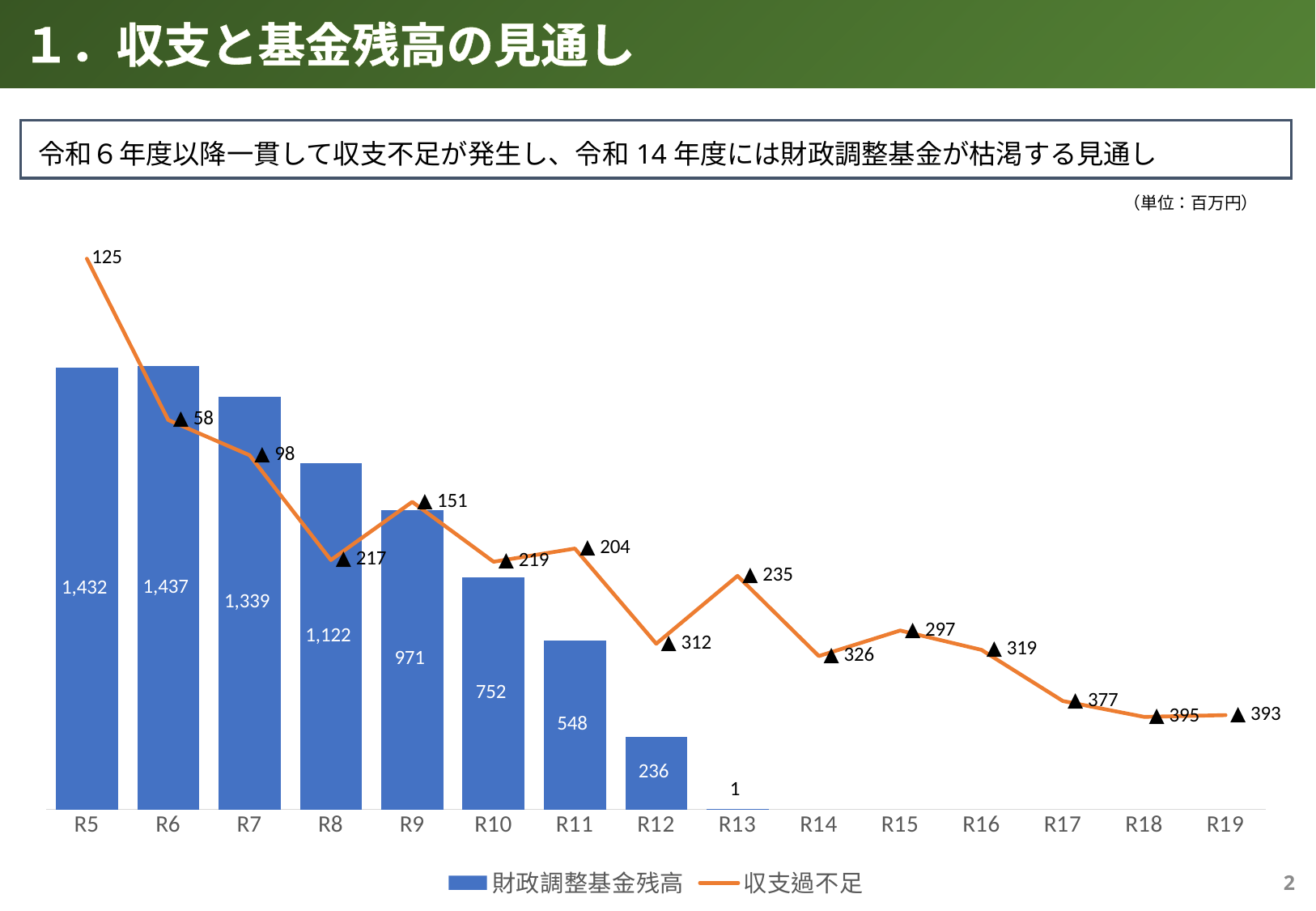
What kind of chart is this? Combined bar and line chart What unit is stated for the chart values? 百万円 What is the value of 収支過不足 for R12? ▲ 312 Do the 財政調整基金残高 bars rise or fall from R6 to R13? Fall What is the value of 財政調整基金残高 for R8? 1,122 Which is larger, the 財政調整基金残高 for R9 or for R10? R9 What is the value of 財政調整基金残高 for R13? 1 What is the value of 収支過不足 for R5? 125 How many series does the legend list? 2 How many years are shown on the x axis? 15 Which year has the highest 財政調整基金残高? R6 What is the difference in 財政調整基金残高 between R11 and R12? 312